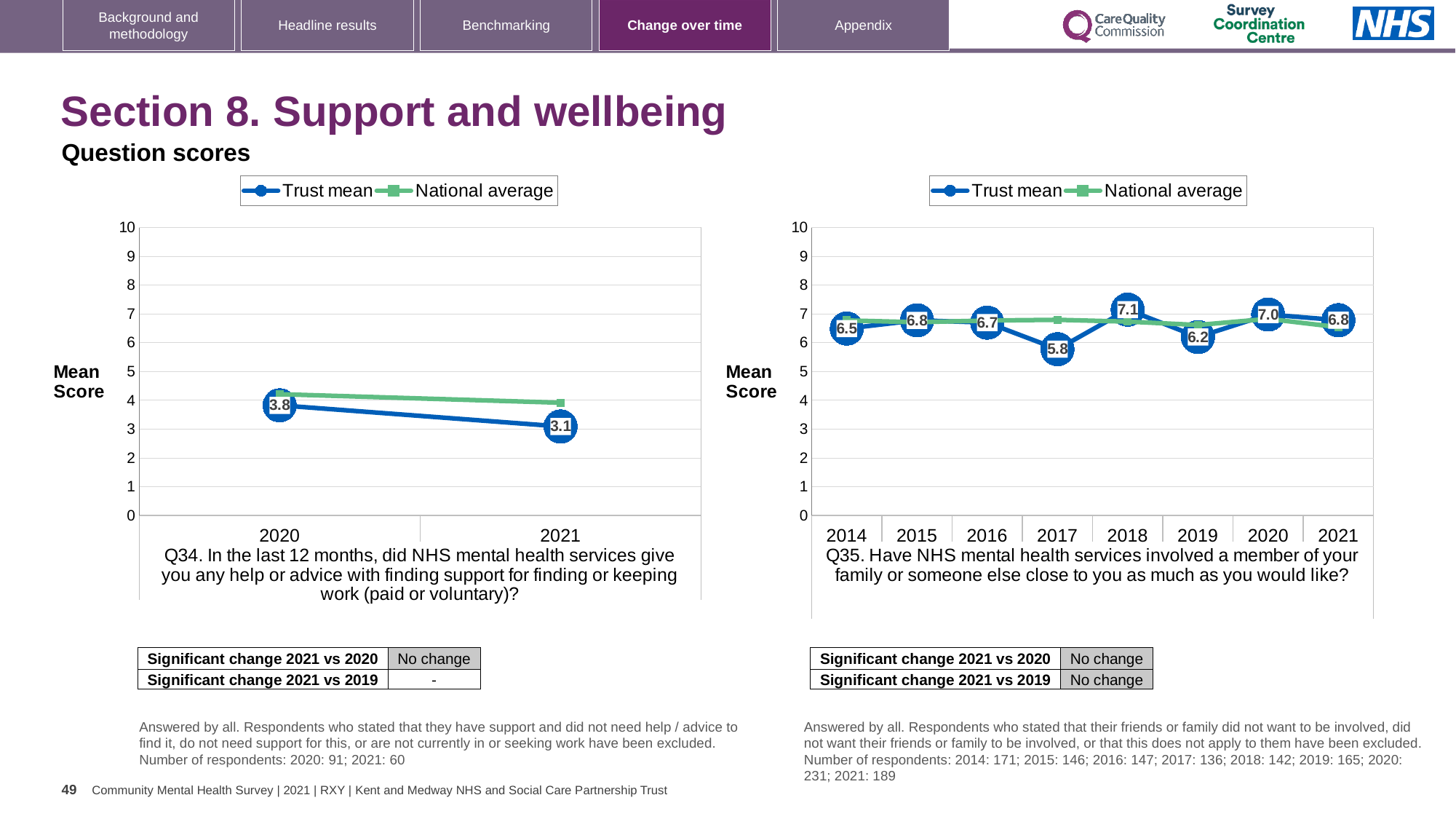
In the Q34 chart on the left, by how much did the Trust mean fall from 2020 to 2021? 0.7 In the Q35 chart on the right, how many years are plotted on the x axis? 8 In the Q35 chart on the right, what is the Trust mean for 2017? 5.8 In the Q35 chart on the right, what is the Trust mean for 2021? 6.8 In the Q35 chart on the right, what is the difference between the Trust mean in 2018 and in 2017? 1.3 In the Q34 chart on the left, does the Trust mean rise or fall from 2020 to 2021? fall In the Q34 chart on the left, is the National average for 2020 greater or less than 5? less In the Q35 chart on the right, which year has the highest Trust mean? 2018 What type of chart is used for Q35 on the right? line chart In the Q34 chart on the left, what is the Trust mean for 2021? 3.1 In the Q34 chart on the left, what is the Trust mean for 2020? 3.8 In the Q35 chart on the right, which year has the lowest Trust mean? 2017